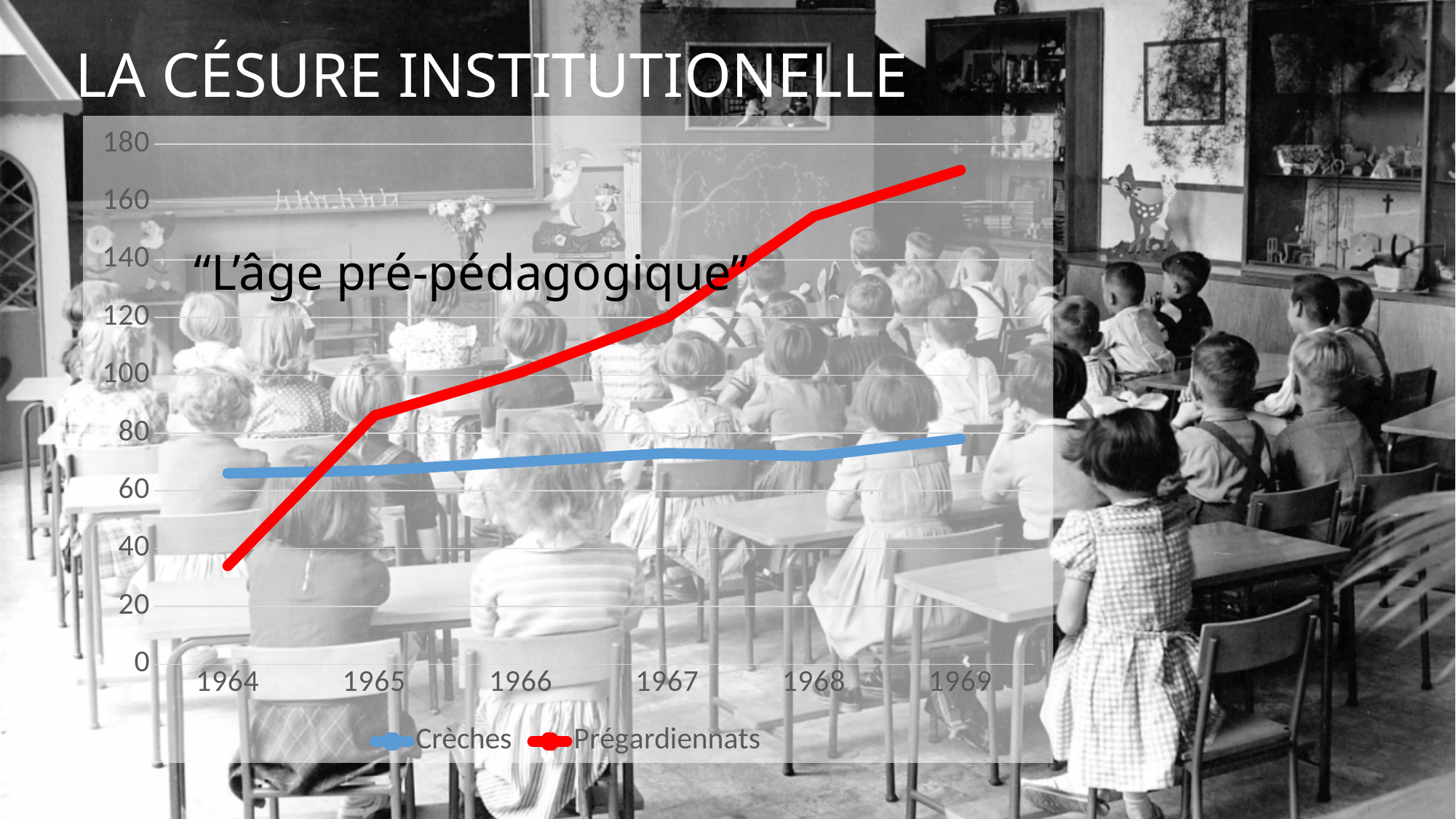
In 1964, which series has the larger value, Crèches or Prégardiennats? Crèches What kind of chart is shown on the slide? line chart Is the value for Prégardiennats in 1964 greater or less than 40? less In 1969, which series has the larger value, Crèches or Prégardiennats? Prégardiennats Which series is shown in red? Prégardiennats How many series does the legend list? 2 In which year is the Prégardiennats value highest? 1969 Is the value for Prégardiennats in 1969 greater or less than 160? greater Does the Prégardiennats line rise or fall from 1964 to 1969? rises How many years are shown on the x axis? 6 In which year is the Prégardiennats value lowest? 1964